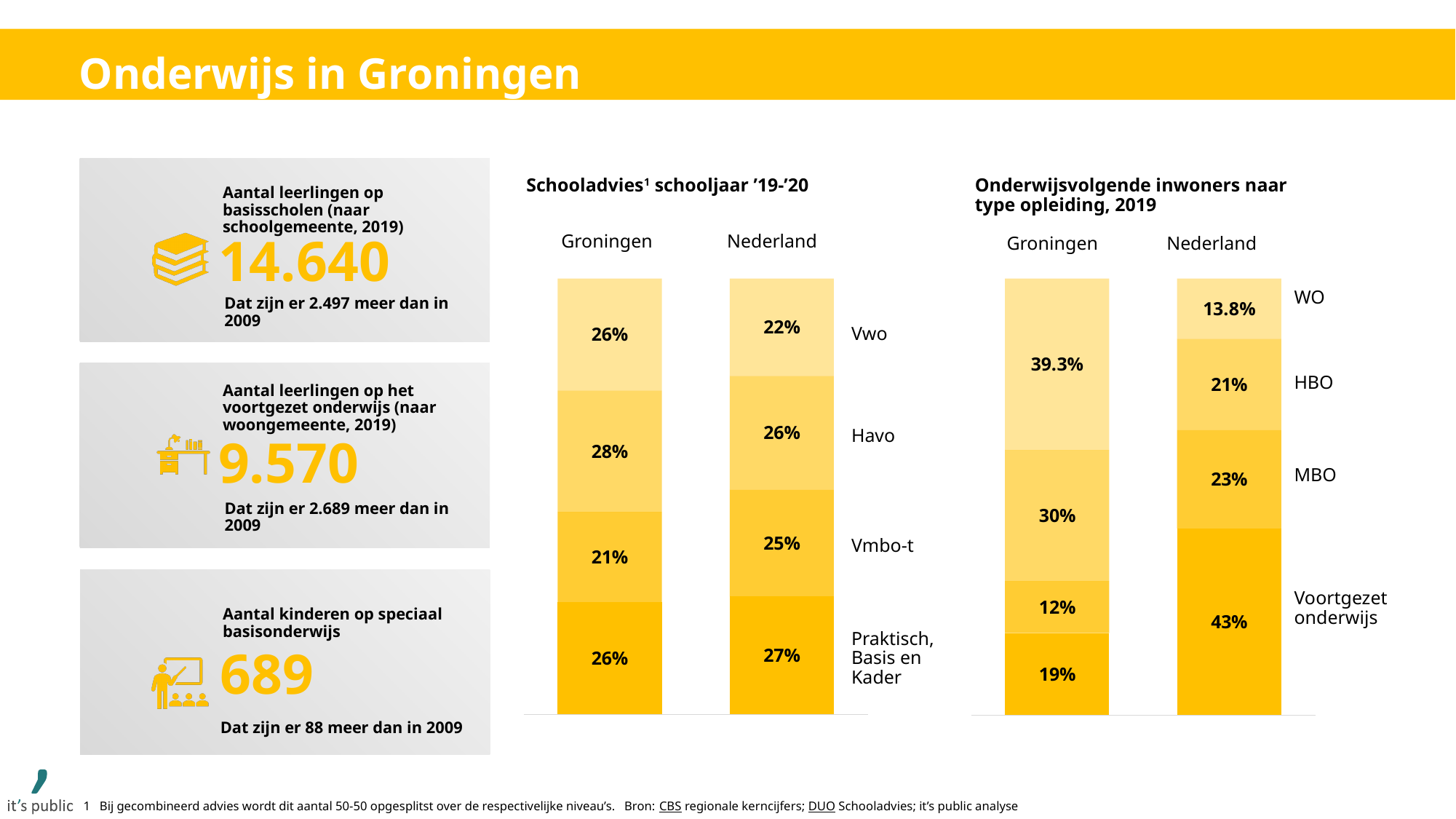
In the 'Schooladvies schooljaar '19-'20' chart, what is the Vmbo-t share for Groningen? 21% In the 'Schooladvies schooljaar '19-'20' chart, what is the Havo share for Nederland? 26% In the 'Schooladvies schooljaar '19-'20' chart, which segment is the largest in the Groningen bar? Havo In the 'Onderwijsvolgende inwoners naar type opleiding, 2019' chart, what is the WO share for Nederland? 13.8% In the 'Schooladvies schooljaar '19-'20' chart, which is larger: the Vwo share for Groningen or for Nederland? Groningen In the 'Onderwijsvolgende inwoners naar type opleiding, 2019' chart, which segment is the smallest in the Groningen bar? MBO In the 'Schooladvies schooljaar '19-'20' chart, what is the difference between the Vmbo-t share for Nederland and for Groningen? 4% In the 'Schooladvies schooljaar '19-'20' chart, how many segments does each stacked bar have? 4 In the 'Onderwijsvolgende inwoners naar type opleiding, 2019' chart, what is the value of the top (lightest) segment of the Groningen bar? 39.3% What type of chart is the 'Onderwijsvolgende inwoners naar type opleiding, 2019' chart? Stacked bar chart In the 'Schooladvies schooljaar '19-'20' chart, what is the Vwo share for Groningen? 26% In the 'Onderwijsvolgende inwoners naar type opleiding, 2019' chart, what is the Voortgezet onderwijs share for Nederland? 43%